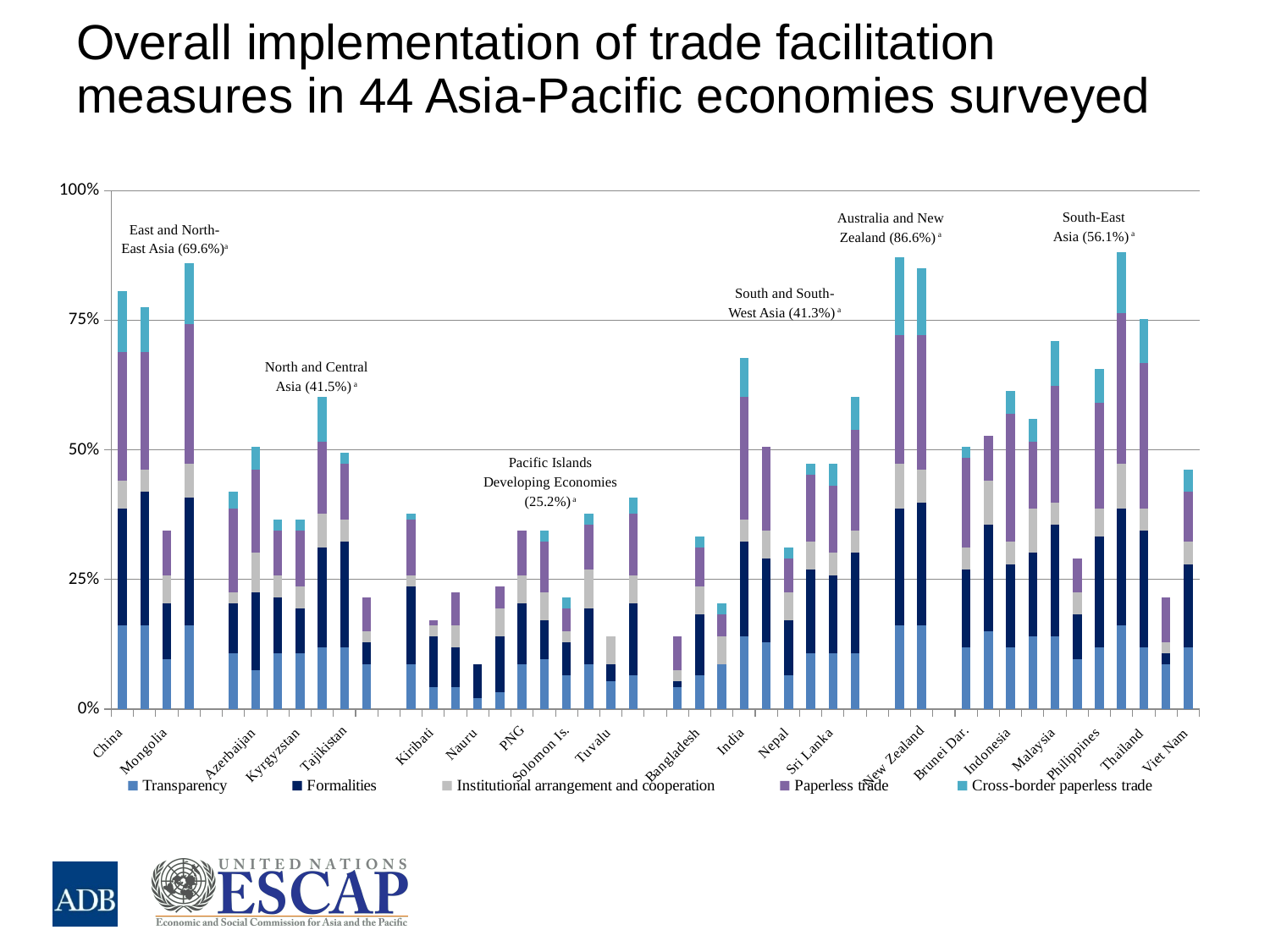
Is the total bar for Nauru greater or less than 25%? less Which series is shown at the bottom of each stacked bar? Transparency Which annotated subregion has the lowest overall implementation percentage? Pacific Islands Developing Economies Which annotated subregion has the highest overall implementation percentage? Australia and New Zealand What overall implementation percentage is annotated for South-East Asia? 56.1% What overall implementation percentage is annotated for Australia and New Zealand? 86.6% How many series does the legend list? 5 What is the difference between the annotated percentages for East and North-East Asia and South-East Asia? 13.5 percentage points Is the total bar for India greater or less than 50%? greater What type of chart is shown on the slide? Stacked bar chart Which has the taller total bar, India or Nepal? India What overall implementation percentage is annotated for the Pacific Islands Developing Economies? 25.2%